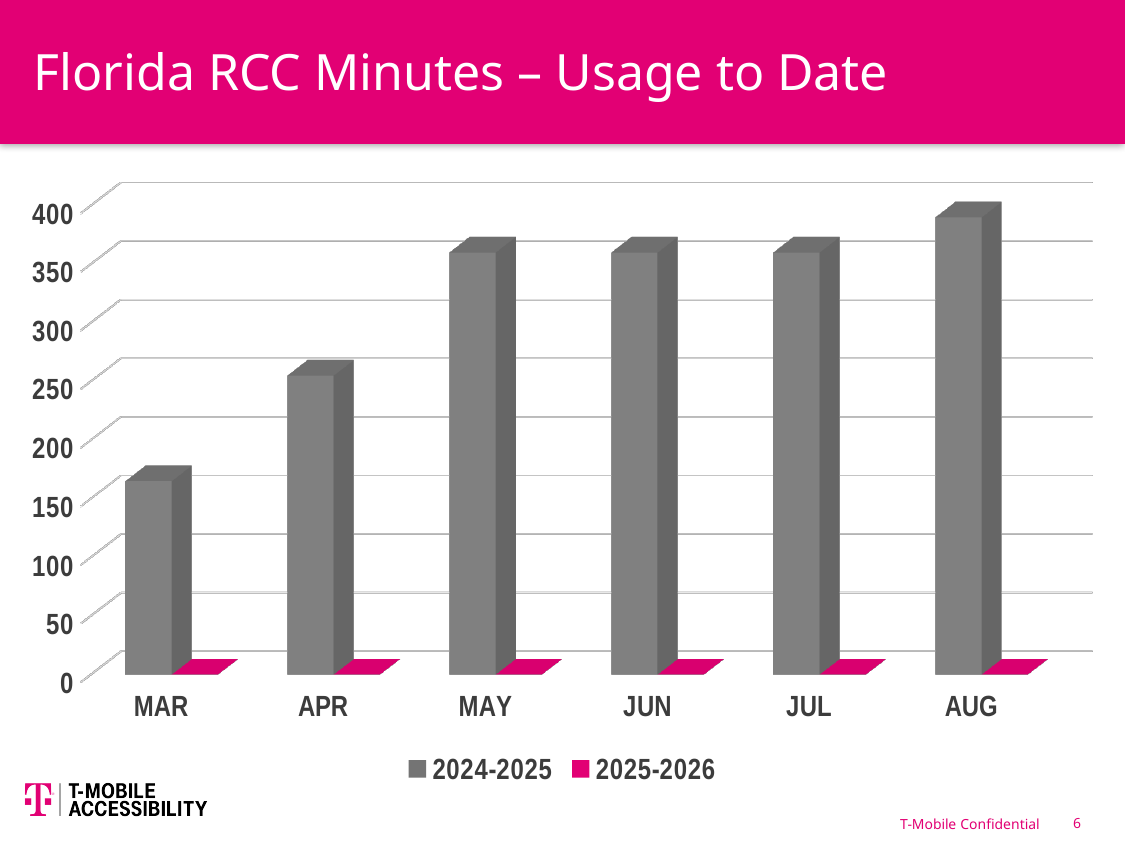
Which month has the lowest 2024-2025 value? MAR Which is larger, the 2024-2025 value for APR or for MAR? APR Is the 2024-2025 value for MAY greater or less than 300? greater Which month has the highest 2024-2025 value? AUG What kind of chart is shown on the slide? bar chart Is the 2024-2025 value for MAR greater or less than 200? less Is the 2024-2025 value for APR greater or less than 300? less How many months are shown on the x axis? 6 What is the title of the chart? Florida RCC Minutes – Usage to Date How many series does the legend list? 2 Do the 2024-2025 values rise or fall from MAR to MAY? rise